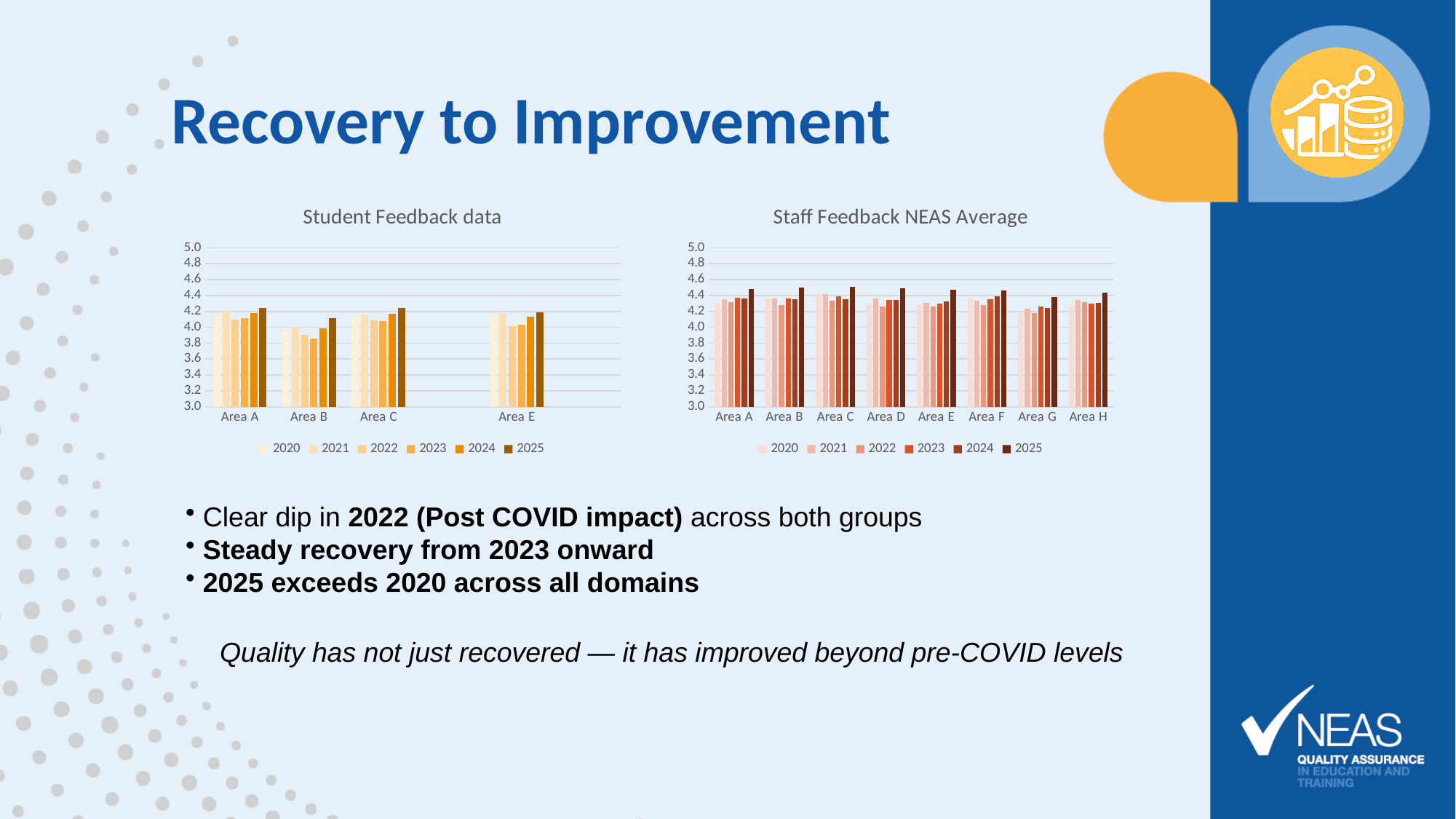
In the Student Feedback data chart, is the 2022 value for Area B greater or less than 4.0? less In the Staff Feedback NEAS Average chart, which is larger for 2020: Area C or Area G? Area C In the Student Feedback data chart, which year has the lowest value for Area B? 2023 In the Staff Feedback NEAS Average chart, is the 2025 value for Area C greater or less than 4.4? greater In the Staff Feedback NEAS Average chart, which year has the highest value for Area B? 2025 How many area categories are labelled on the x axis of the Staff Feedback NEAS Average chart? 8 How many series does the legend of the Staff Feedback NEAS Average chart list? 6 In the Student Feedback data chart, do the values for Area B rise or fall from 2022 to 2025? rise In the Student Feedback data chart, is the 2025 value for Area B greater or less than 4.0? greater How many area categories are labelled on the x axis of the Student Feedback data chart? 4 What kind of chart is the Student Feedback data chart? bar chart In the Student Feedback data chart, which is larger for Area B: the 2022 value or the 2025 value? 2025